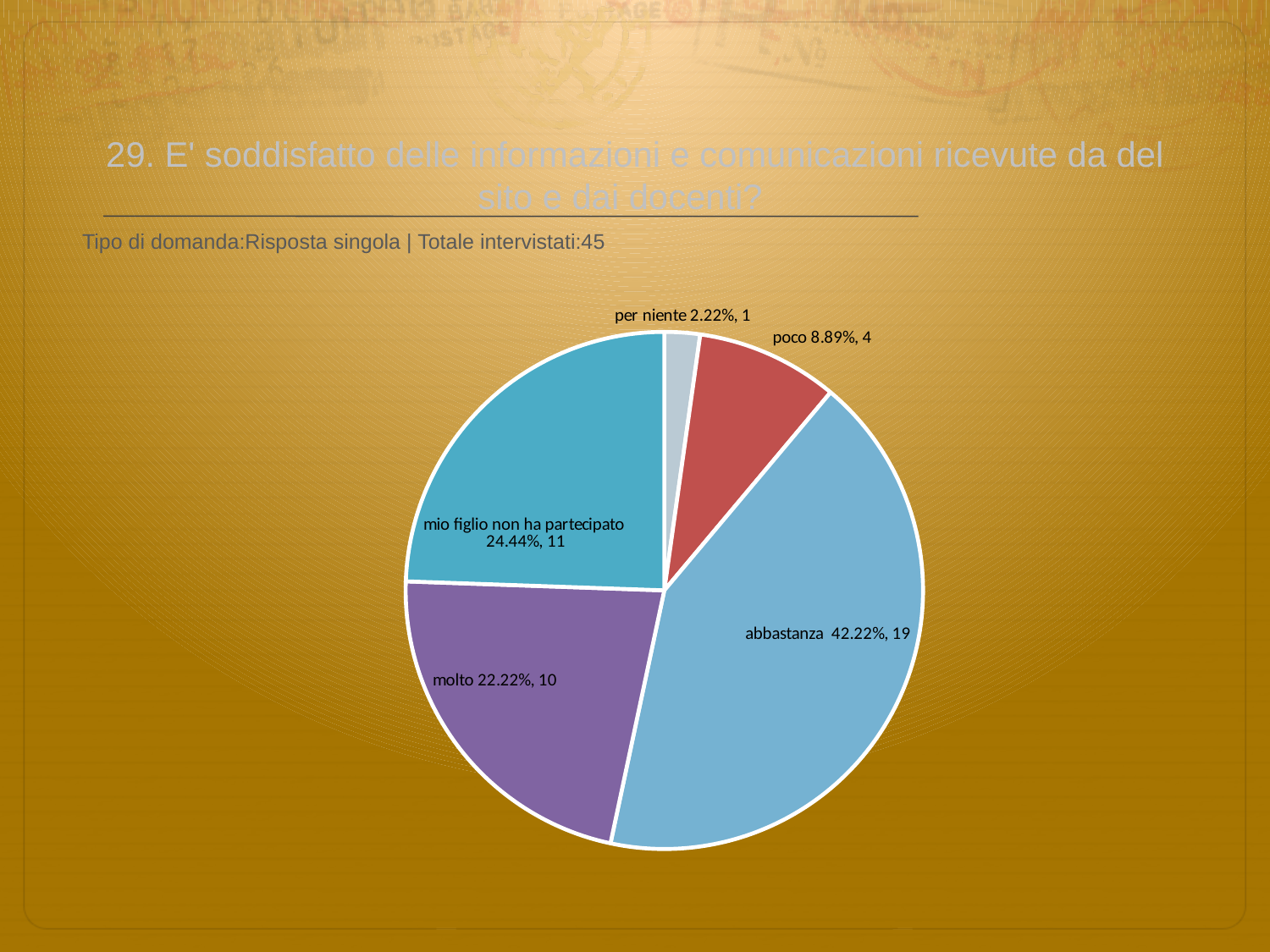
What is the total number of respondents shown in the subtitle? 45 How many slices does the pie chart have? 5 How many respondents answered 'molto'? 10 How many respondents answered 'poco'? 4 What is the difference in respondent count between 'abbastanza' and 'molto'? 9 Which category has the largest slice? abbastanza Which category has the smallest slice? per niente What percentage share does the 'abbastanza' slice have? 42.22% What percentage share does the 'mio figlio non ha partecipato' slice have? 24.44% What kind of chart is shown on the slide? pie chart What percentage share does the 'per niente' slice have? 2.22% Which has more respondents, 'poco' or 'per niente'? poco